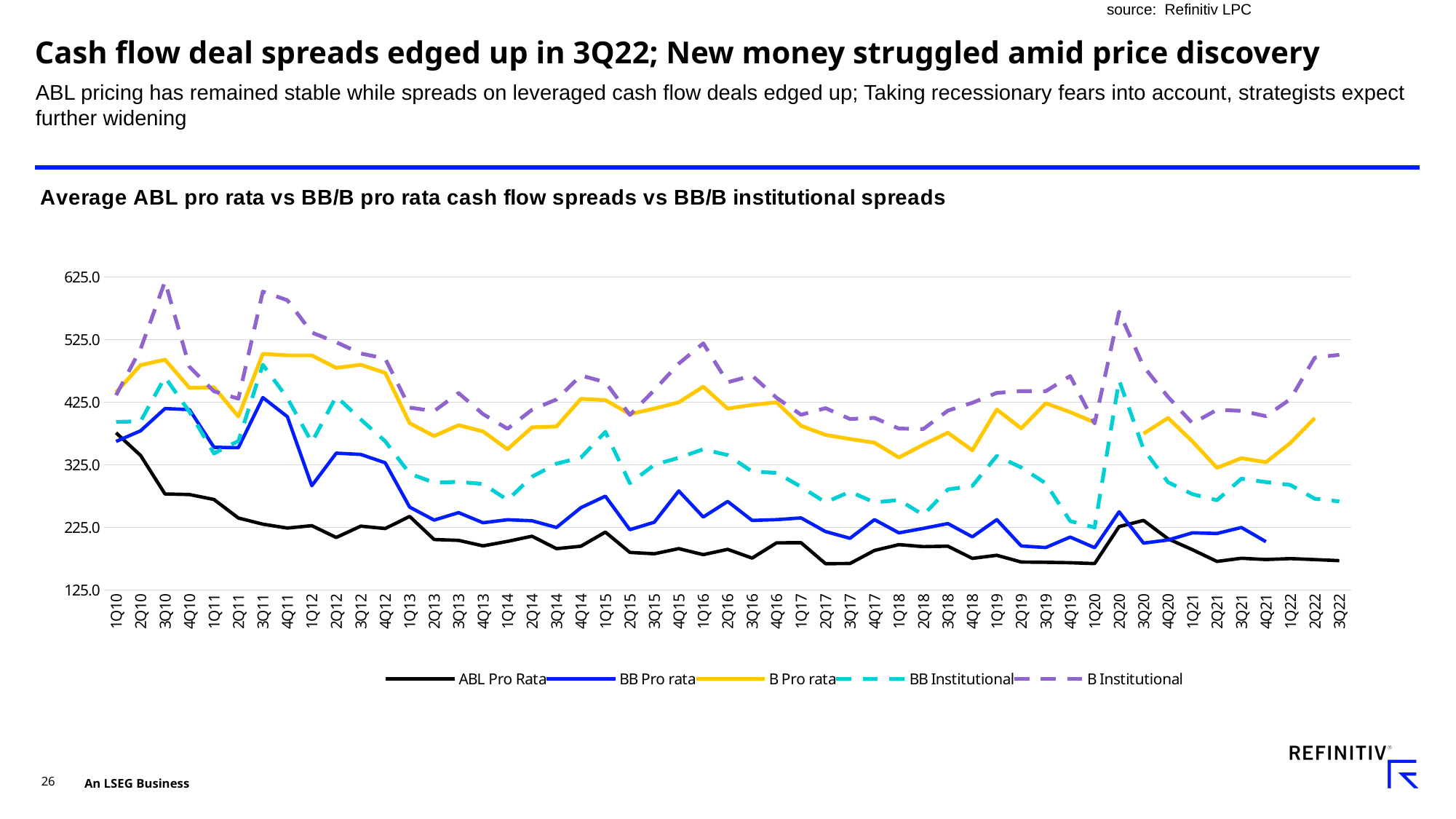
What is the title of the chart? Average ABL pro rata vs BB/B pro rata cash flow spreads vs BB/B institutional spreads Is the value for B Institutional at 3Q10 greater or less than 525.0? greater What kind of chart is shown on the slide? line chart How many series does the legend list? 5 Which series has the highest value at 3Q10? B Institutional How many quarters are plotted along the x axis? 51 Is the value for ABL Pro Rata at 3Q22 greater or less than 225.0? less Which series is drawn as a solid black line? ABL Pro Rata Is the value for BB Pro rata at 1Q12 greater or less than 325.0? less Which series has the lowest value at 3Q22? ABL Pro Rata